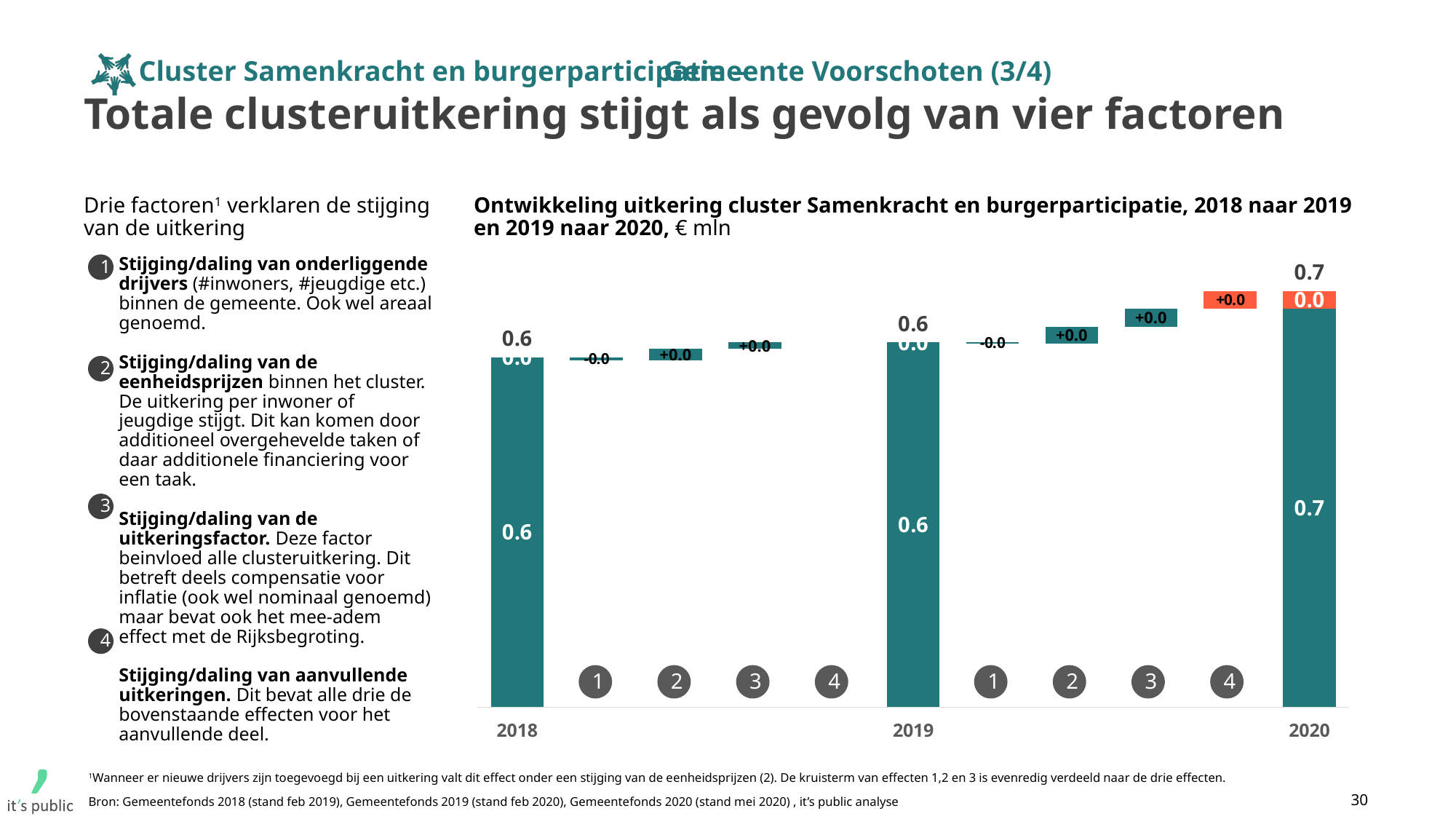
How many year totals (full bars) are shown in the chart? 3 What value is printed inside the teal part of the 2020 bar? 0.7 What is the difference between the total for 2020 and the total for 2018? 0.1 What kind of chart is shown on the slide? bar chart In what unit are the values in the chart expressed, according to the chart title? € mln What is the total uitkering value shown above the bar for 2018? 0.6 Which year has the highest total uitkering? 2020 What is the total uitkering value shown above the bar for 2020? 0.7 Does the total uitkering rise or fall from 2018 to 2020? rise Is the total for 2020 larger or smaller than the total for 2018? larger What is the total uitkering value shown above the bar for 2019? 0.6 What value is printed in the orange part of the 2020 bar? 0.0